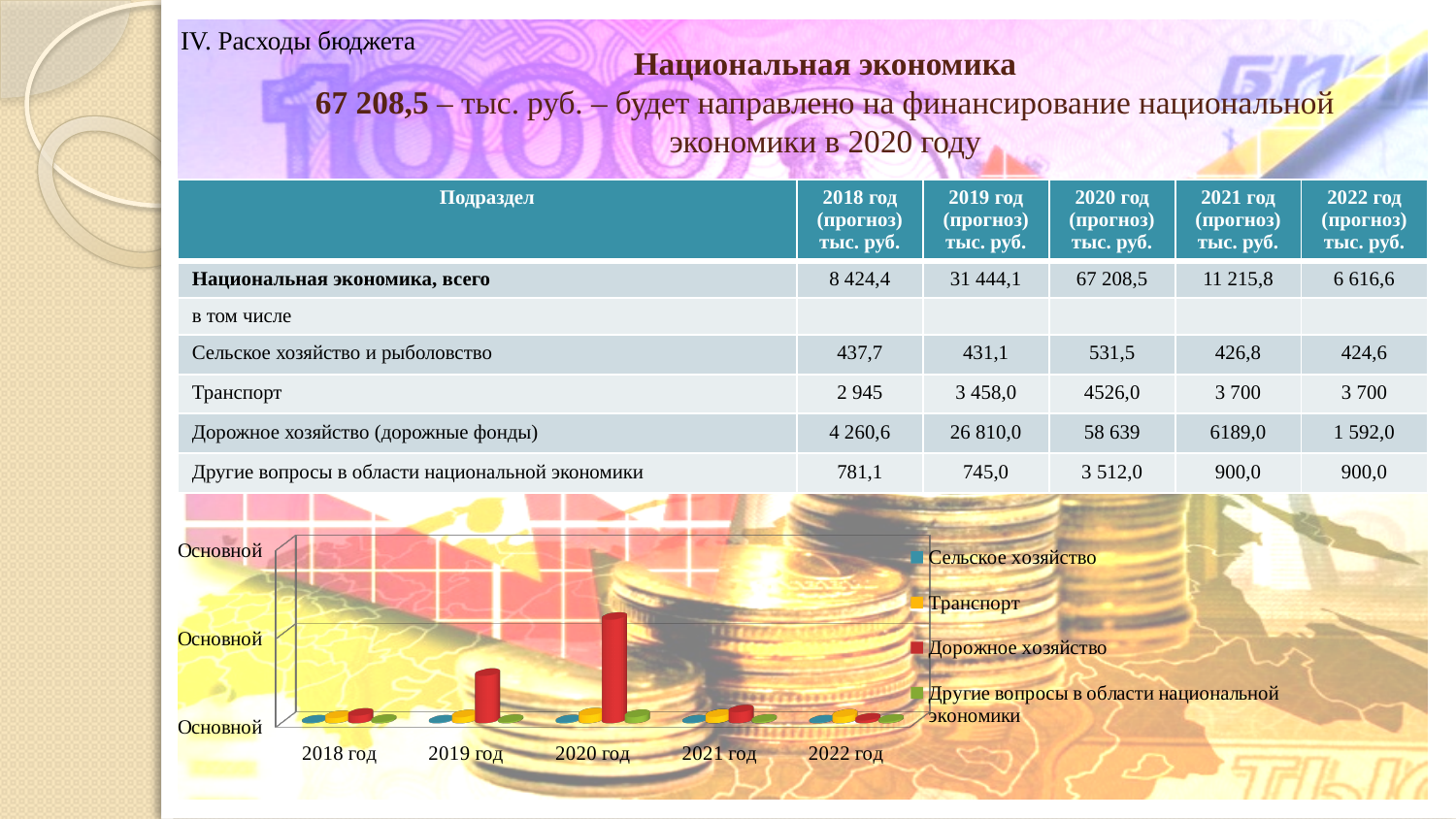
According to the table on the slide, what is the value for Дорожное хозяйство (дорожные фонды) in 2020 год? 58 639 Is the Дорожное хозяйство bar larger in 2021 год or in 2020 год? 2020 год What colour are the bars for Дорожное хозяйство in the chart? red How many series does the chart legend list? 4 Is the Дорожное хозяйство bar larger in 2019 год or in 2020 год? 2020 год Which series has the tallest bar in the chart overall? Дорожное хозяйство How many years (categories) are shown on the x axis of the chart? 5 Does the Дорожное хозяйство series rise or fall from 2018 год to 2020 год? rise What kind of chart is shown at the bottom of the slide? bar chart What is the last entry listed in the chart legend? Другие вопросы в области национальной экономики Does the Дорожное хозяйство series rise or fall from 2020 год to 2022 год? fall In which year is the bar for Дорожное хозяйство the tallest? 2020 год